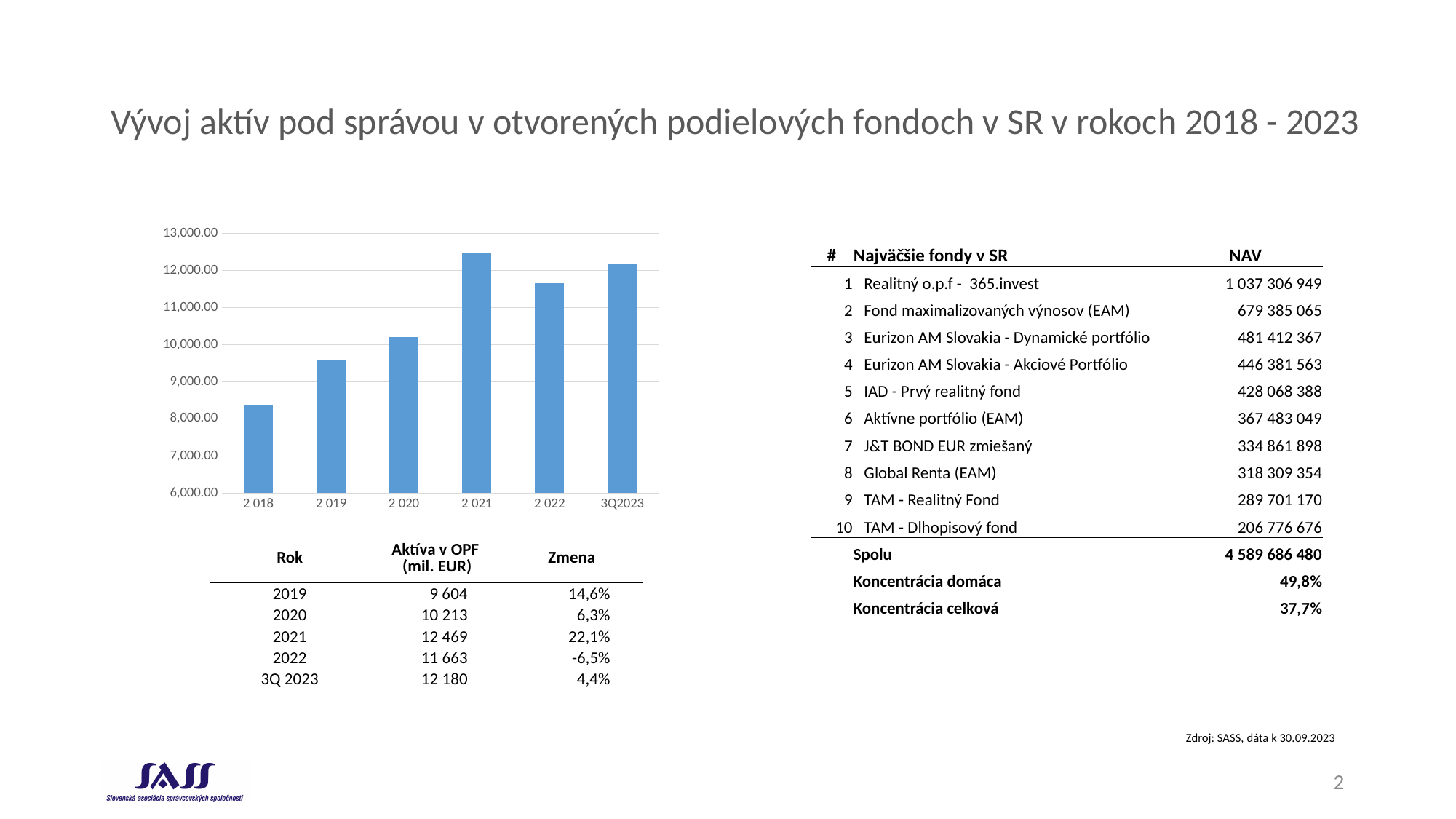
Which period has the highest bar in the chart? 2 021 Is the value for 2 022 greater or less than 12,000.00? less Is the value for 2 019 greater or less than 10,000.00? less Which is larger, the value for 2 022 or the value for 3Q2023? 3Q2023 Which is larger, the value for 2 019 or the value for 2 020? 2 020 Which period has the lowest bar in the chart? 2 018 Is the value for 2 018 greater or less than 9,000.00? less What is the lowest value shown on the chart's vertical axis? 6,000.00 How many bars (periods) does the chart show? 6 What kind of chart is shown on the slide? bar chart Do the values generally rise or fall from 2 018 to 2 021? rise